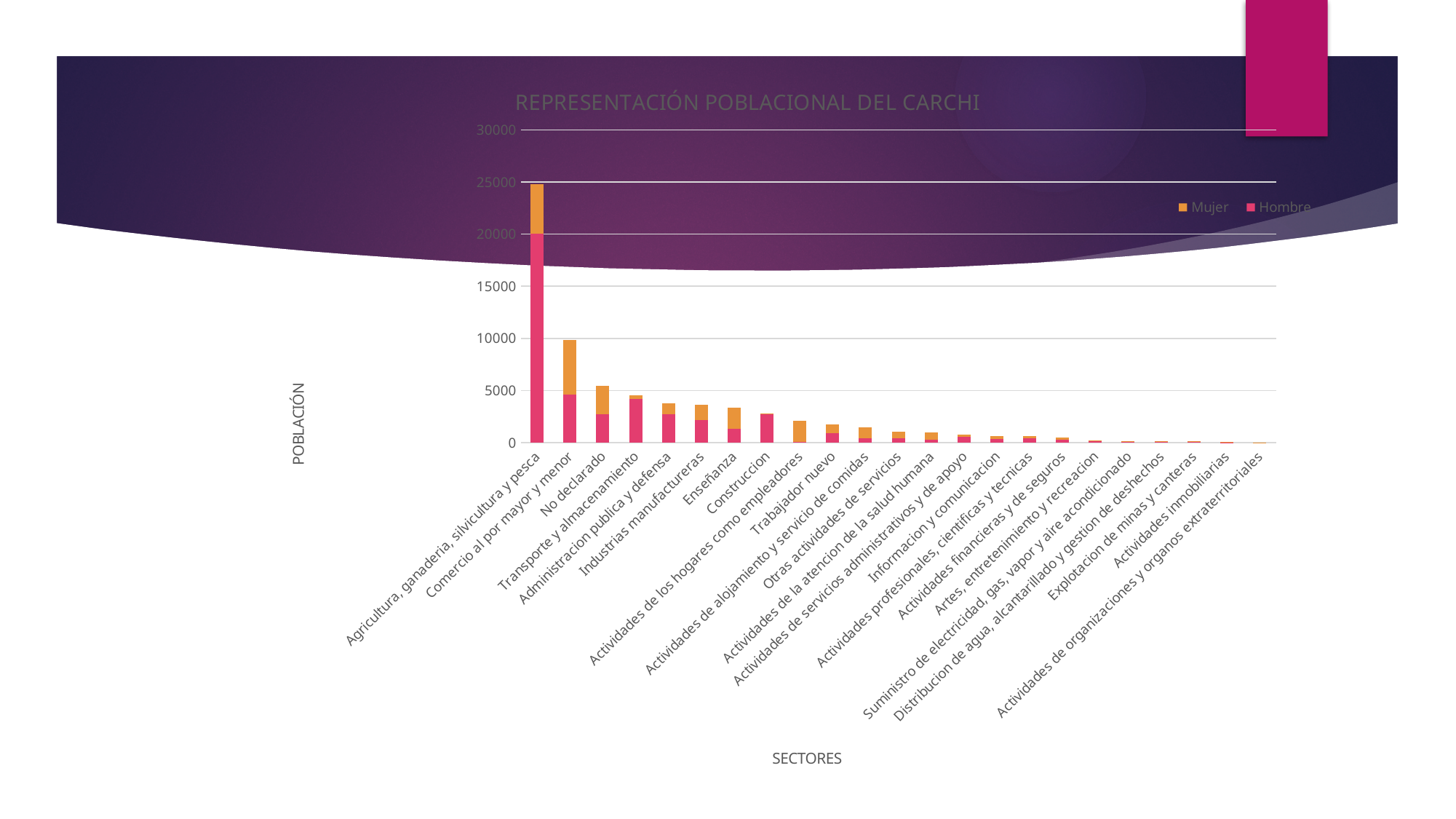
Which sector has the highest total population? Agricultura, ganaderia, silvicultura y pesca How many series does the legend list? 2 Do the total bar values generally rise or fall from left to right along the x axis? fall What kind of chart is shown on the slide? Stacked bar chart What is the title of the chart? REPRESENTACIÓN POBLACIONAL DEL CARCHI Is the total value for Construccion greater or less than 5000? less Which series are listed in the legend? Mujer and Hombre Which has a larger total population, Agricultura, ganaderia, silvicultura y pesca or Comercio al por mayor y menor? Agricultura, ganaderia, silvicultura y pesca How many sectors (categories) are shown on the x axis? 23 Is the total value for Comercio al por mayor y menor greater or less than 5000? greater Is the total value for Agricultura, ganaderia, silvicultura y pesca greater or less than 20000? greater